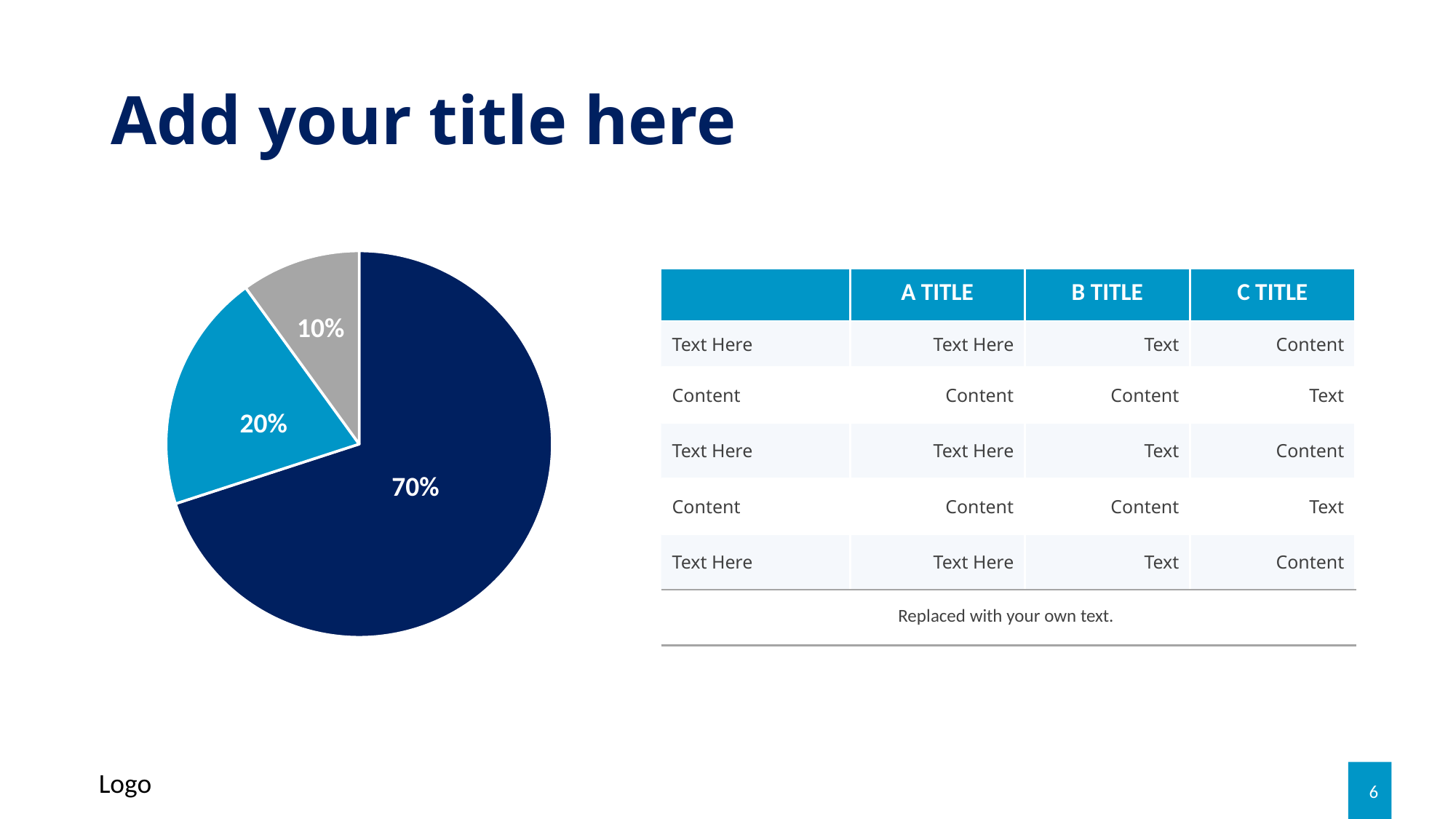
What is the value shown on the smallest slice of the pie chart? 10% What colour is the largest slice of the pie chart? dark navy blue Which slice of the pie chart is larger, the light blue one or the grey one? the light blue one What is the combined share of the light blue and grey slices of the pie chart? 30% What kind of chart is shown on the left of the slide? pie chart What is the difference between the largest and smallest slices of the pie chart? 60% What percentage is shown on the dark navy slice of the pie chart? 70% What is the value shown on the largest slice of the pie chart? 70% What percentage is shown on the grey slice of the pie chart? 10% What is the difference between the light blue slice and the grey slice of the pie chart? 10% What percentage is shown on the light blue slice of the pie chart? 20% How many slices does the pie chart have? 3